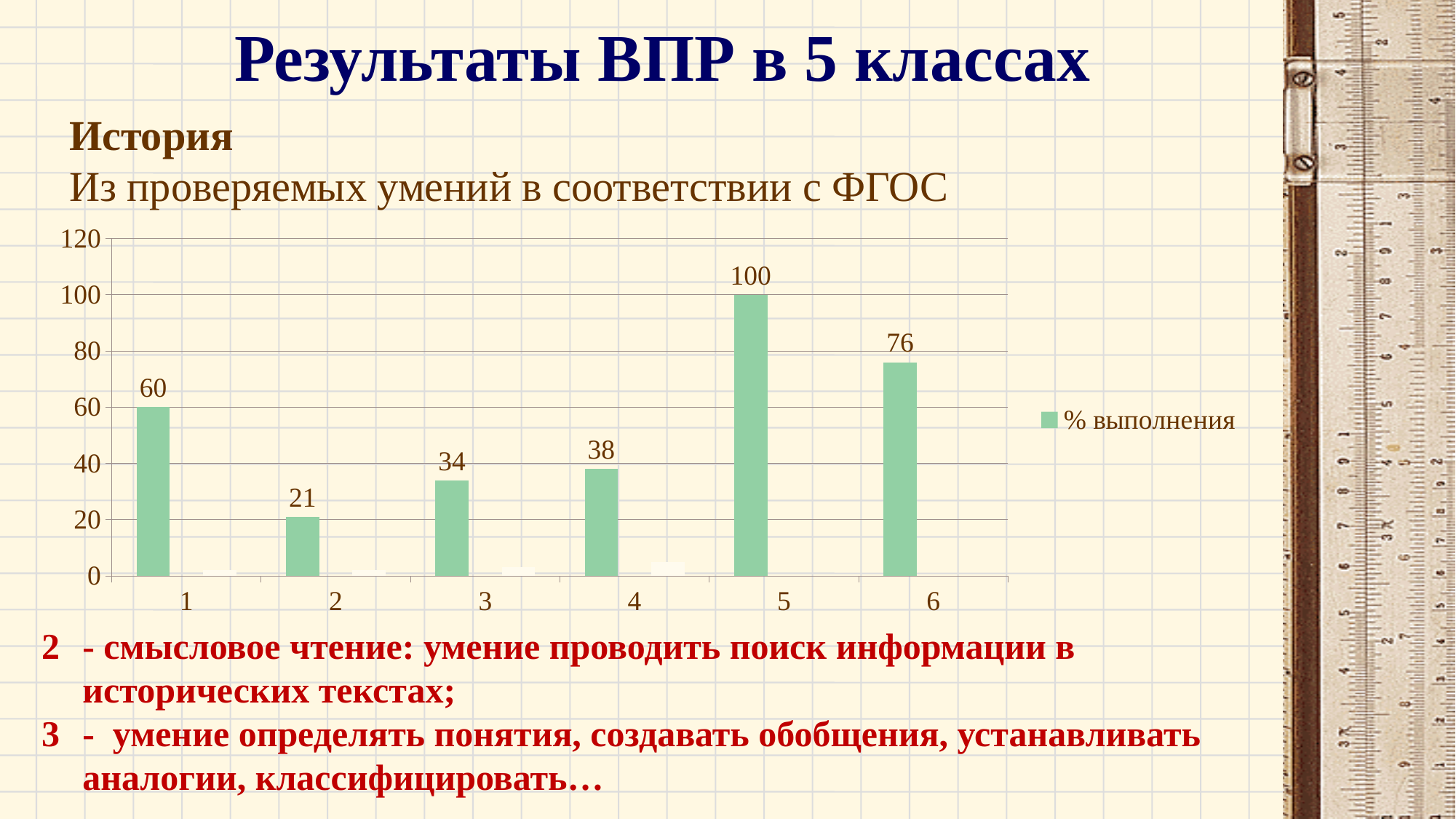
What is the % выполнения value for category 1? 60 Which is larger, the value for category 1 or the value for category 4? category 1 What is the % выполнения value for category 5? 100 How many categories are shown on the x axis? 6 What is the difference between the values for category 4 and category 3? 4 What series name is listed in the legend? % выполнения What is the difference between the values for category 5 and category 6? 24 Which category has the highest % выполнения? 5 Is the value for category 2 greater or less than 40? less Which category has the lowest % выполнения? 2 What is the % выполнения value for category 6? 76 What kind of chart is shown on the slide? bar chart